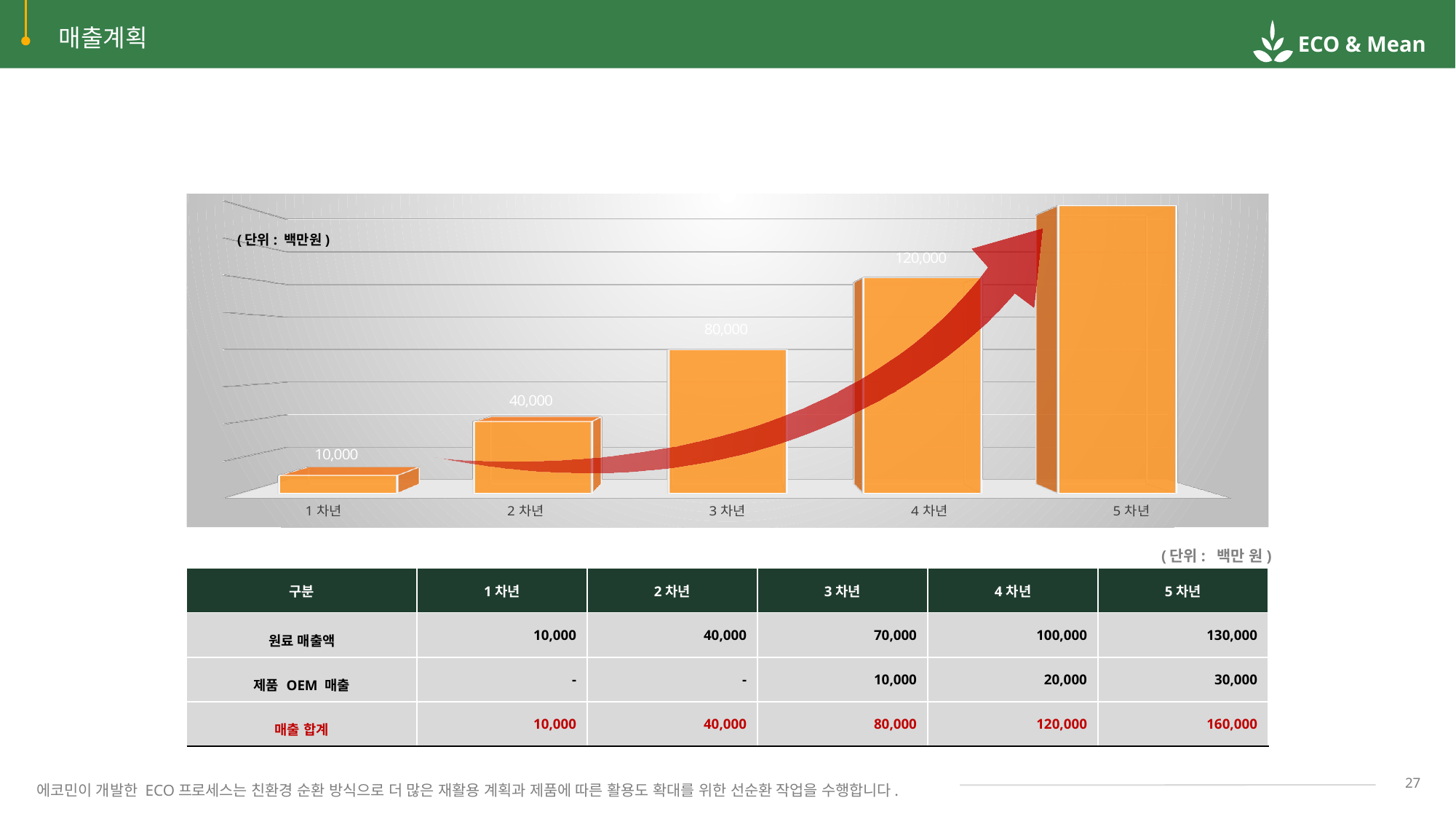
What is the value for 4 차년 in the bar chart? 120,000 Which year has the lowest bar in the chart? 1 차년 What kind of chart is shown on the slide? Bar chart What is the value for 1 차년 in the bar chart? 10,000 How many bars (categories) are shown in the chart? 5 What is the difference between the values for 4 차년 and 2 차년 in the chart? 80,000 Which is larger in the chart, the value for 3 차년 or the value for 2 차년? 3 차년 Which year has the highest bar in the chart? 5 차년 What is the value for 3 차년 in the bar chart? 80,000 What is the difference between the values for 3 차년 and 1 차년 in the chart? 70,000 Do the values in the chart rise or fall from 1 차년 to 5 차년? Rise What is the value for 2 차년 in the bar chart? 40,000